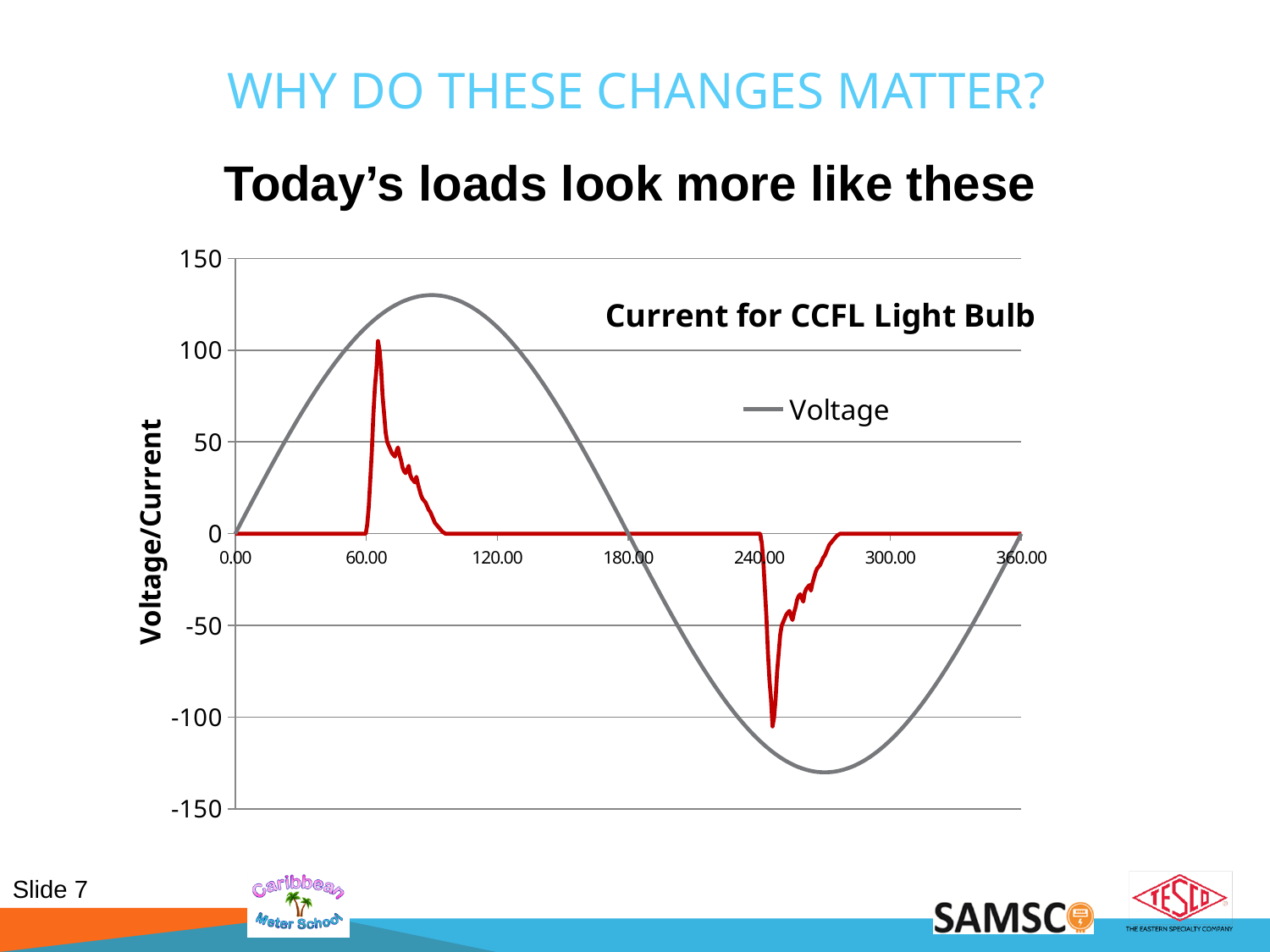
Does the Voltage line rise or fall between 0.00 and 60.00 on the horizontal axis? rise How many tick labels are shown on the horizontal axis? 7 What is the title shown on the chart? Current for CCFL Light Bulb Is the lowest value of the Voltage line greater or less than -100? less What is the lowest value shown on the vertical axis? -150 What is the highest value shown on the vertical axis? 150 What is the title of the vertical axis? Voltage/Current Is the peak value of the Voltage line greater or less than 100? greater What is the largest value shown on the horizontal axis? 360.00 At 90 on the horizontal axis, which is larger, the Voltage line or the red current line? Voltage What kind of chart is shown on the slide? line chart Is the peak value of the red current line greater or less than 50? greater